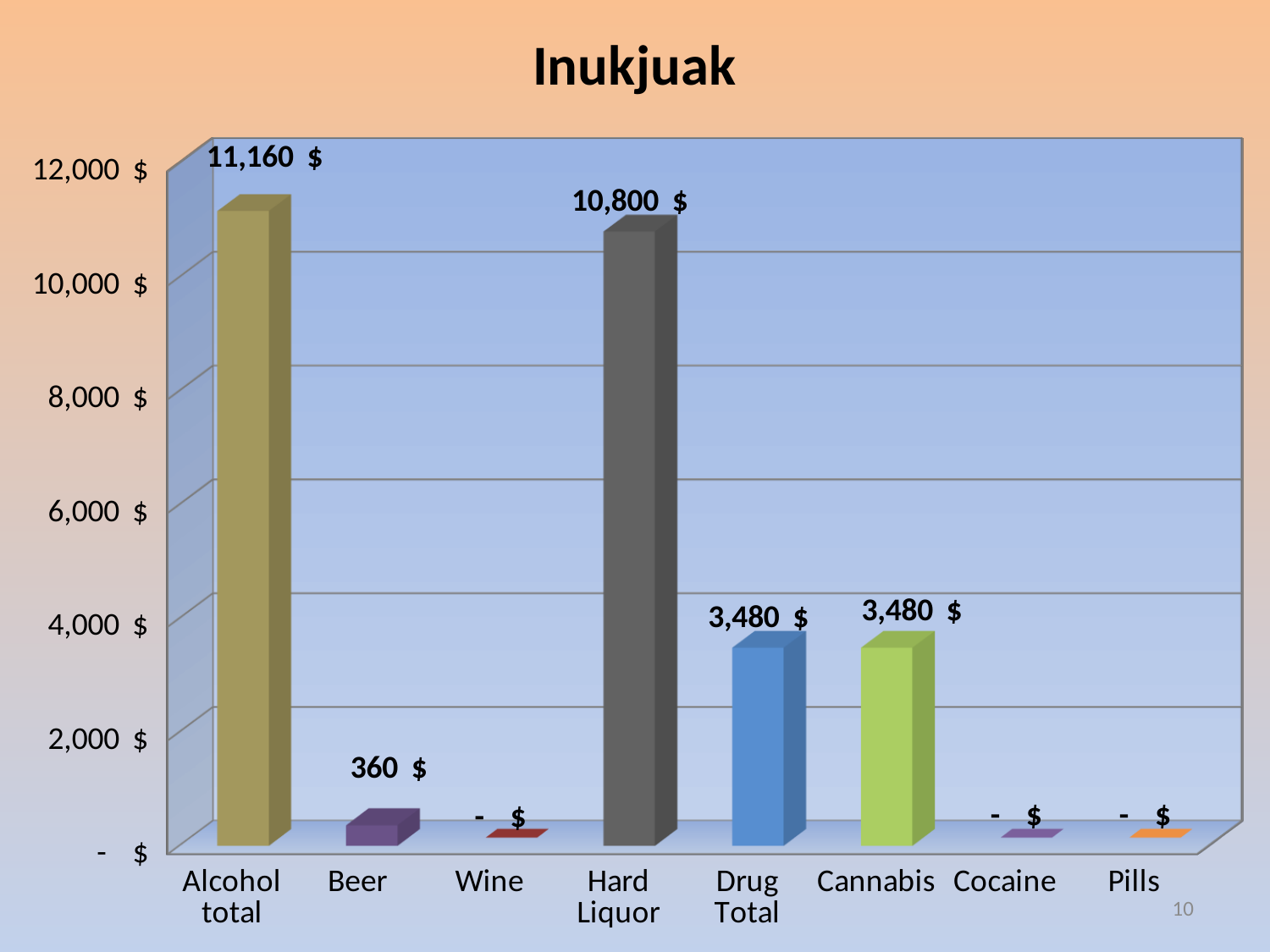
What is the value for Hard Liquor? 10,800 $ What is the value for Alcohol total? 11,160 $ Which is larger, Beer or Cannabis? Cannabis How many categories are shown on the x axis? 8 Is the value for Drug Total greater or less than 4,000? less What is the value for Beer? 360 $ Which category has the highest value? Alcohol total What is the difference between Hard Liquor and Drug Total? 7,320 $ What is the title of the chart? Inukjuak What is the difference between Alcohol total and Hard Liquor? 360 $ What is the value for Cannabis? 3,480 $ What kind of chart is shown on the slide? bar chart